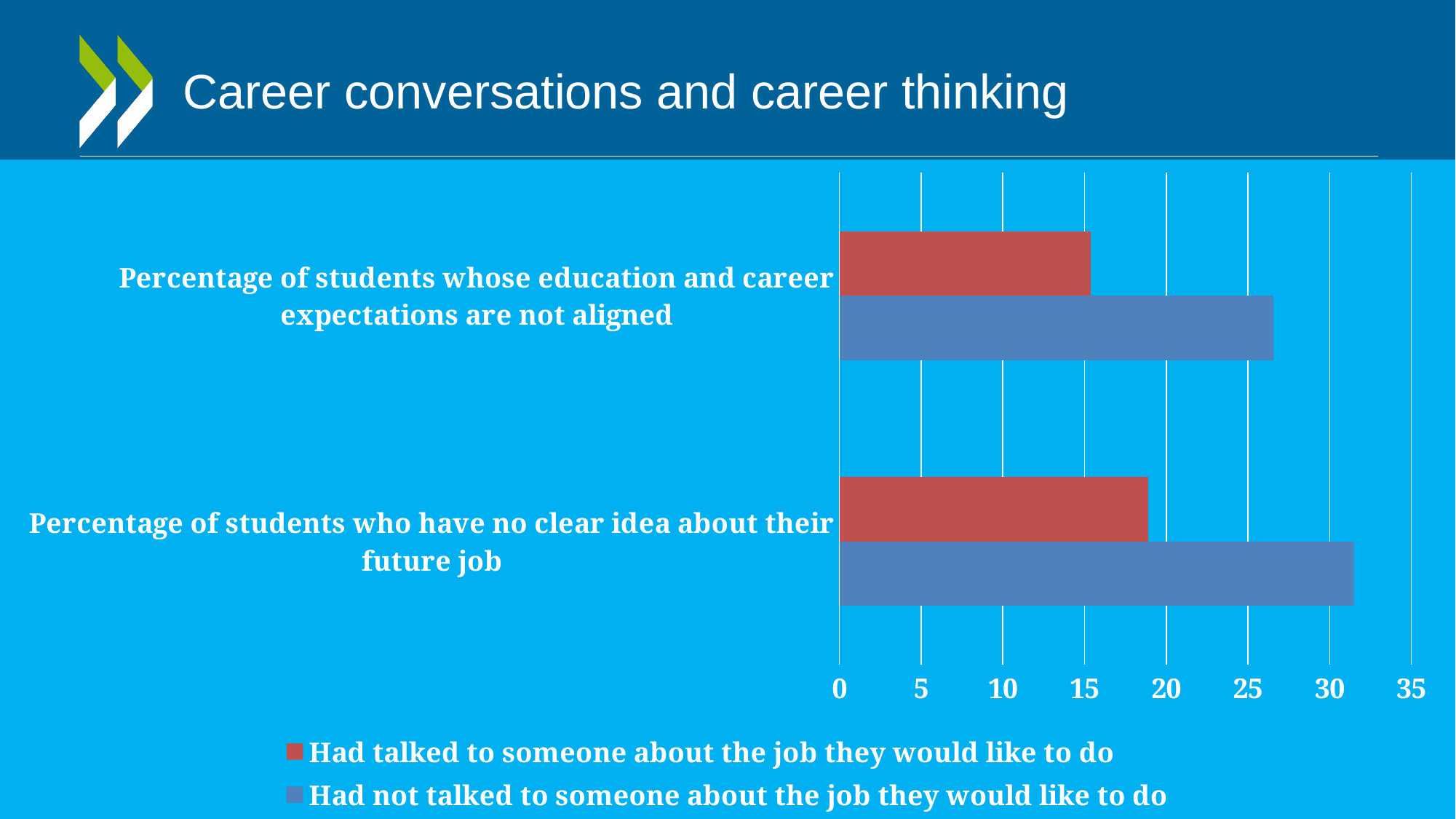
Is the value for 'Had not talked to someone about the job they would like to do' in the category 'Percentage of students whose education and career expectations are not aligned' greater or less than 25? greater Which series has the higher value for 'Percentage of students whose education and career expectations are not aligned'? Had not talked to someone about the job they would like to do Is the value for 'Had talked to someone about the job they would like to do' in the category 'Percentage of students who have no clear idea about their future job' greater or less than 20? less What colour represents the series 'Had talked to someone about the job they would like to do'? red What kind of chart is shown on the slide? bar chart How many categories are plotted on the chart? 2 Which series has the higher value for 'Percentage of students who have no clear idea about their future job': 'Had talked to someone about the job they would like to do' or 'Had not talked to someone about the job they would like to do'? Had not talked to someone about the job they would like to do How many series does the legend list? 2 Is the value for 'Had not talked to someone about the job they would like to do' in the category 'Percentage of students who have no clear idea about their future job' greater or less than 30? greater Which bar on the chart is the shortest? Had talked to someone about the job they would like to do, Percentage of students whose education and career expectations are not aligned What is the title of the slide? Career conversations and career thinking Which bar on the chart is the longest? Had not talked to someone about the job they would like to do, Percentage of students who have no clear idea about their future job